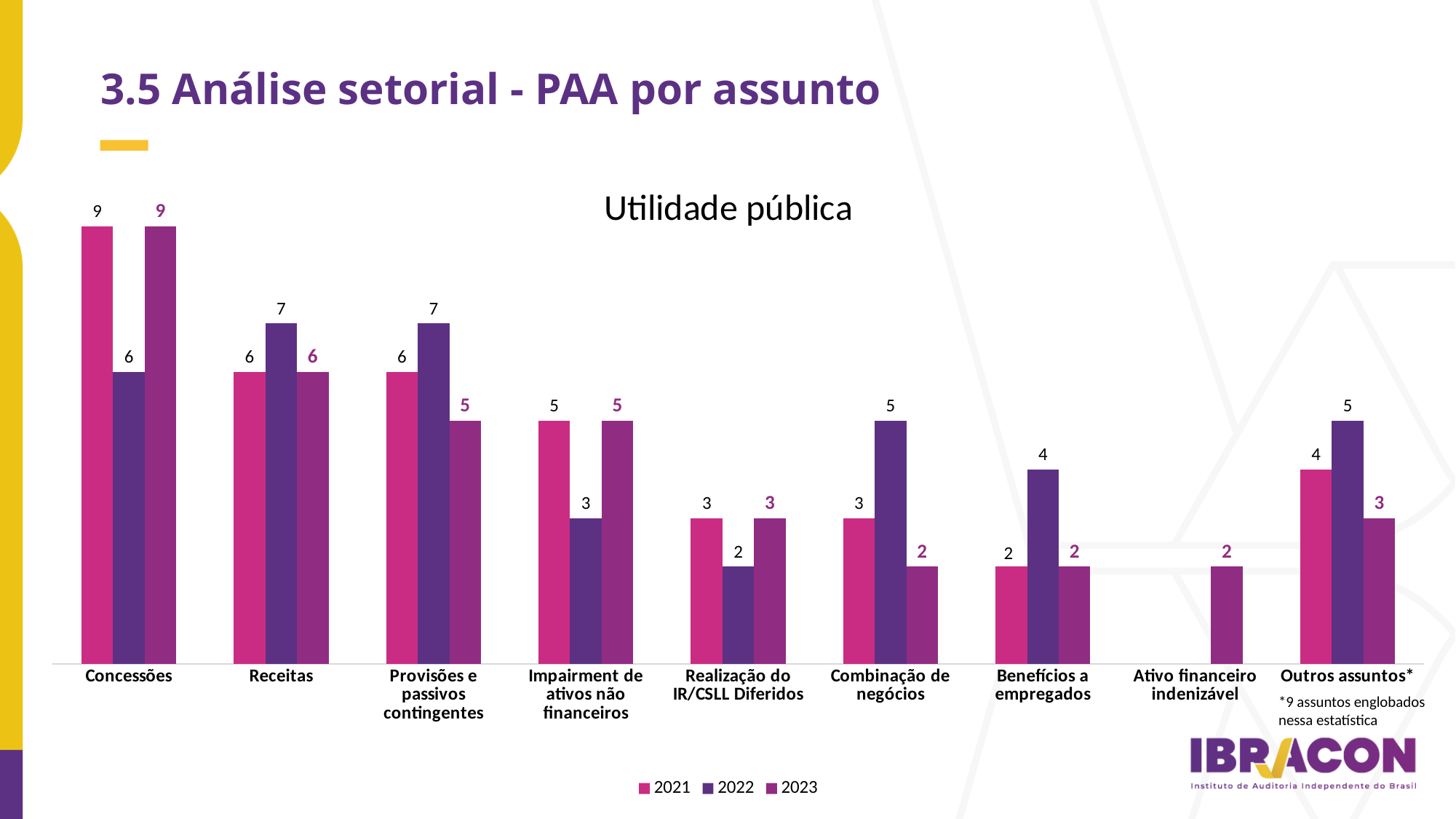
What is the 2022 value for Impairment de ativos não financeiros? 3 What is the value for Receitas in 2022? 7 How many series does the legend list? 3 Which category has the lowest value in the 2021 series? Benefícios a empregados How many categories are shown on the x axis? 9 What kind of chart is shown on the slide? Bar chart Which category has the highest value in the 2022 series? Receitas and Provisões e passivos contingentes (both 7) What is the 2023 value for Provisões e passivos contingentes? 5 What is the title of the chart? Utilidade pública What is the value for Concessões in 2021? 9 What is the difference between the 2022 and 2023 values for Combinação de negócios? 3 For Outros assuntos*, which is larger: the 2022 value or the 2023 value? 2022